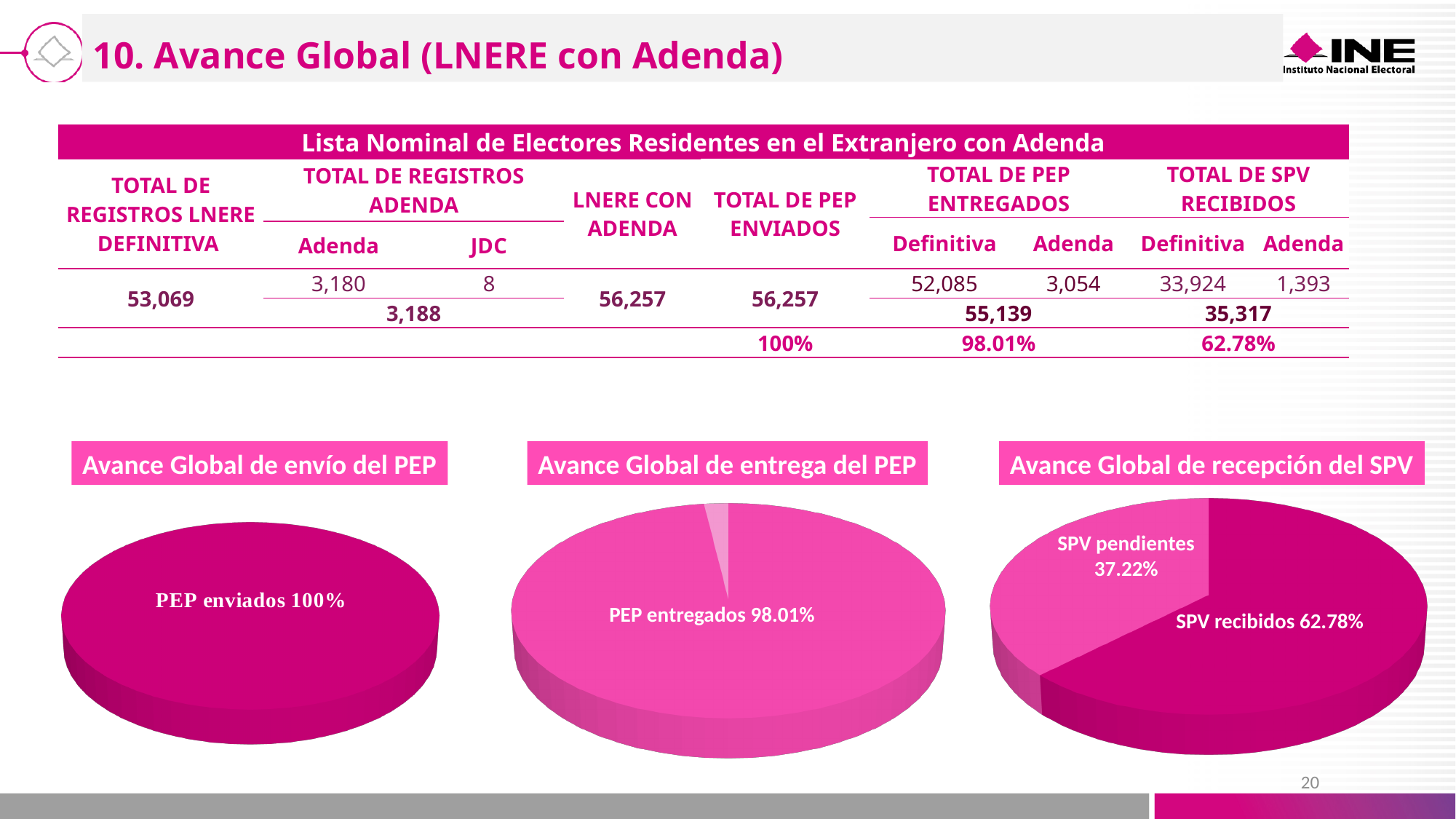
In the 'Avance Global de recepción del SPV' chart, what share is labelled for SPV recibidos? 62.78% In the 'Avance Global de recepción del SPV' chart, which slice is the smallest? SPV pendientes What is the title of the rightmost chart on the slide? Avance Global de recepción del SPV In the 'Avance Global de envío del PEP' chart, what share is labelled for PEP enviados? 100% What kind of chart is 'Avance Global de envío del PEP'? pie chart In the 'Avance Global de recepción del SPV' chart, what share is labelled for SPV pendientes? 37.22% In the 'Avance Global de recepción del SPV' chart, which slice is the largest? SPV recibidos In the 'Avance Global de recepción del SPV' chart, which slice is larger: SPV recibidos or SPV pendientes? SPV recibidos How many pie charts are shown on the slide? 3 In the 'Avance Global de recepción del SPV' chart, what is the difference in percentage points between SPV recibidos and SPV pendientes? 25.56 How many labelled slices does the 'Avance Global de recepción del SPV' chart have? 2 In the 'Avance Global de entrega del PEP' chart, what share is labelled for PEP entregados? 98.01%